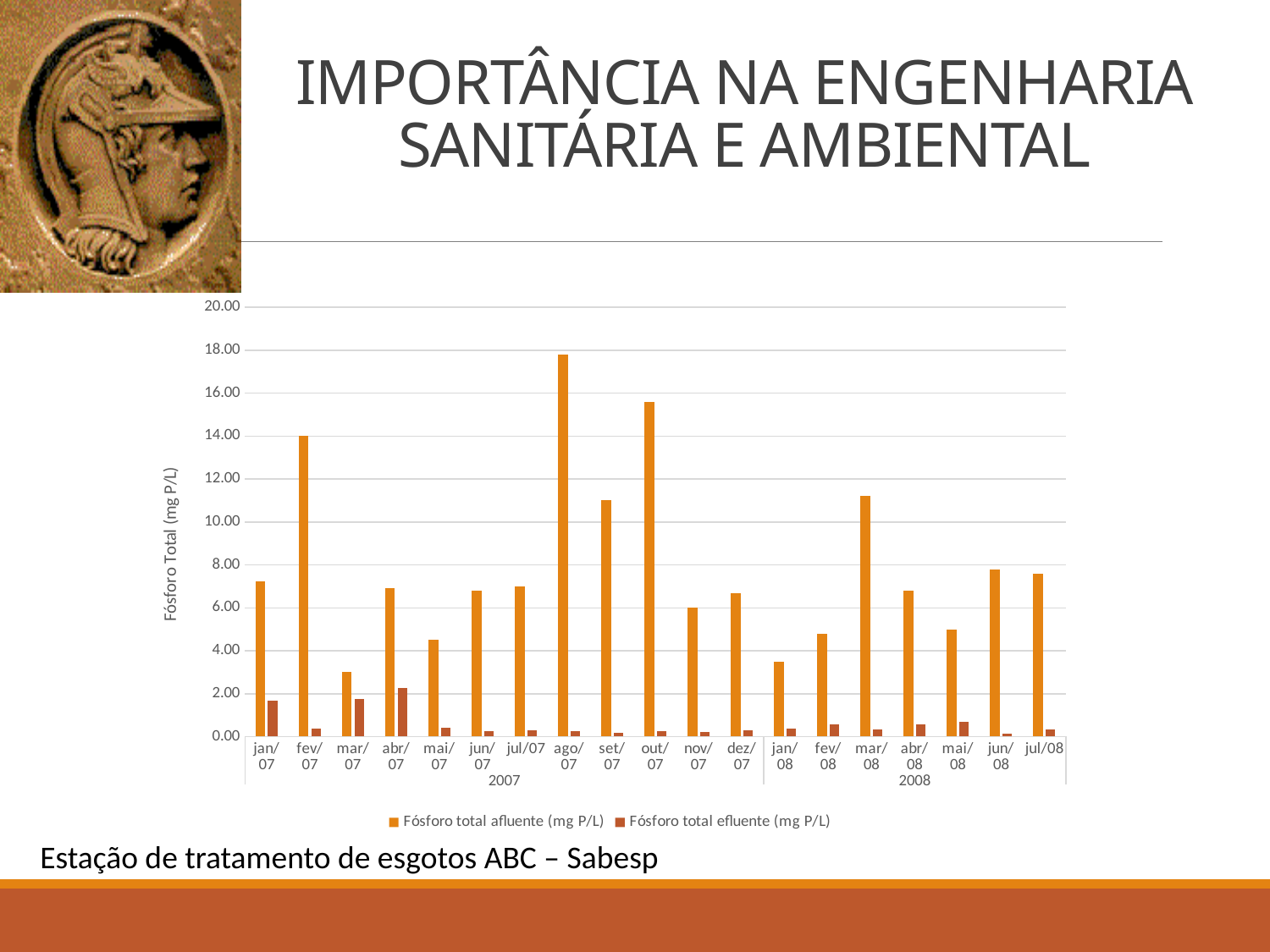
Which month has the larger 'Fósforo total afluente (mg P/L)' value, ago/07 or out/07? ago/07 How many months (categories) are plotted along the x axis of the chart? 19 What is the label of the vertical axis of the chart? Fósforo Total (mg P/L) Is the 'Fósforo total afluente (mg P/L)' value for ago/07 greater or less than 16.00? greater Which month has the larger 'Fósforo total afluente (mg P/L)' value, fev/07 or set/07? fev/07 In which month is the 'Fósforo total afluente (mg P/L)' value highest? ago/07 In which month is the 'Fósforo total efluente (mg P/L)' value highest? abr/07 Is the 'Fósforo total afluente (mg P/L)' value for mar/07 greater or less than 4.00? less What kind of chart is shown on the slide? bar chart Is the 'Fósforo total afluente (mg P/L)' value for mar/08 greater or less than 10.00? greater In which month is the 'Fósforo total afluente (mg P/L)' value lowest? mar/07 How many series does the chart legend list? 2